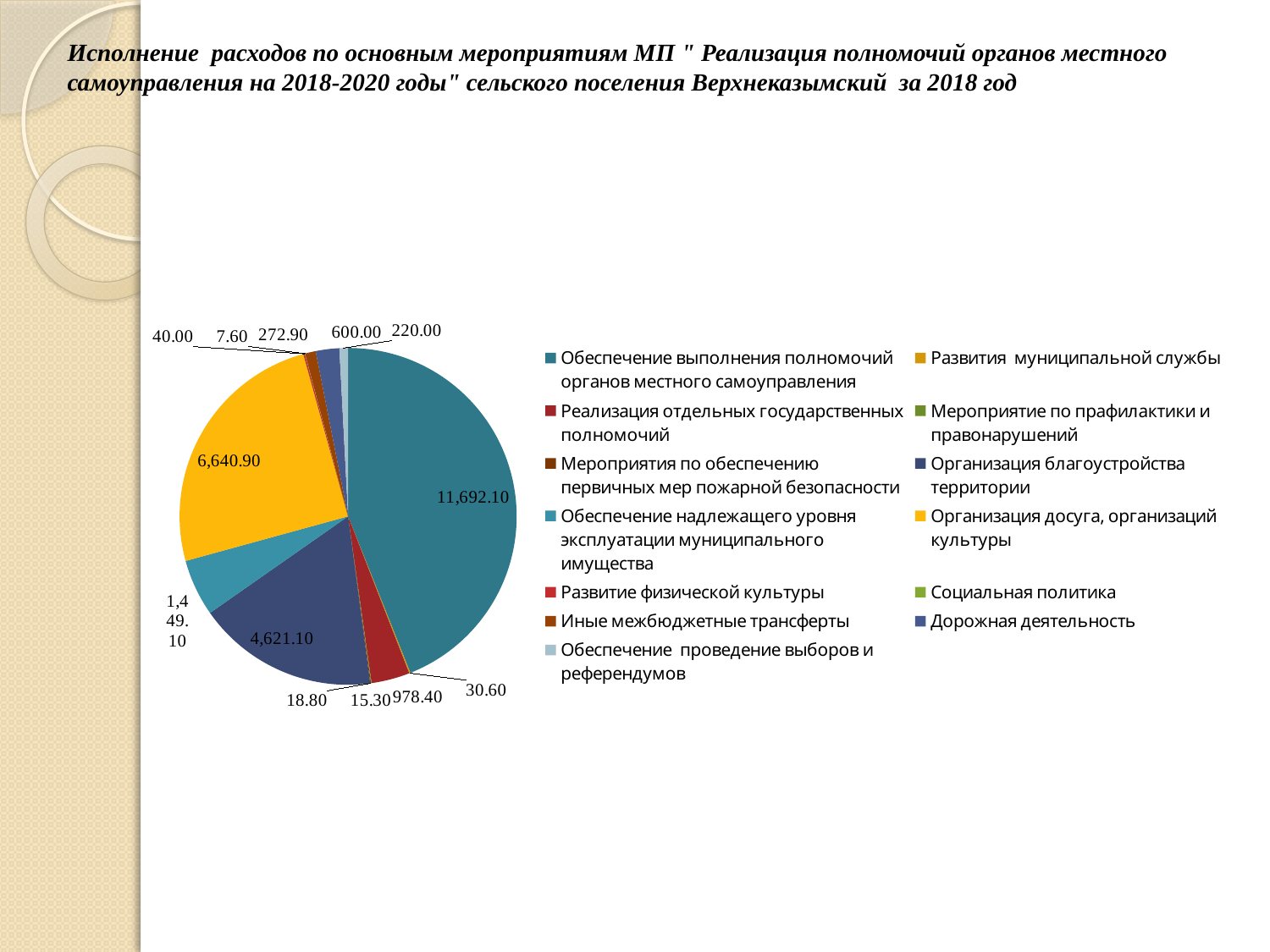
What is the value of the slice for Обеспечение выполнения полномочий органов местного самоуправления? 11,692.10 What is the value of the largest slice in the pie chart? 11,692.10 What is the difference between the slice labelled 6,640.90 and the slice labelled 4,621.10? 2,019.80 What is the value of the slice for Обеспечение надлежащего уровня эксплуатации муниципального имущества? 1,449.10 What is the smallest value labelled on the pie chart? 7.60 How many entries does the legend of the pie chart list? 13 What is the difference between the slice labelled 11,692.10 and the slice labelled 6,640.90? 5,051.20 Which year does the chart title say the expenditure data is for? 2018 How many slices does the pie chart have? 13 Which is larger: the slice labelled 600.00 or the slice labelled 220.00? 600.00 What kind of chart is shown on the slide? pie chart Which category has the largest slice in the pie chart? Обеспечение выполнения полномочий органов местного самоуправления